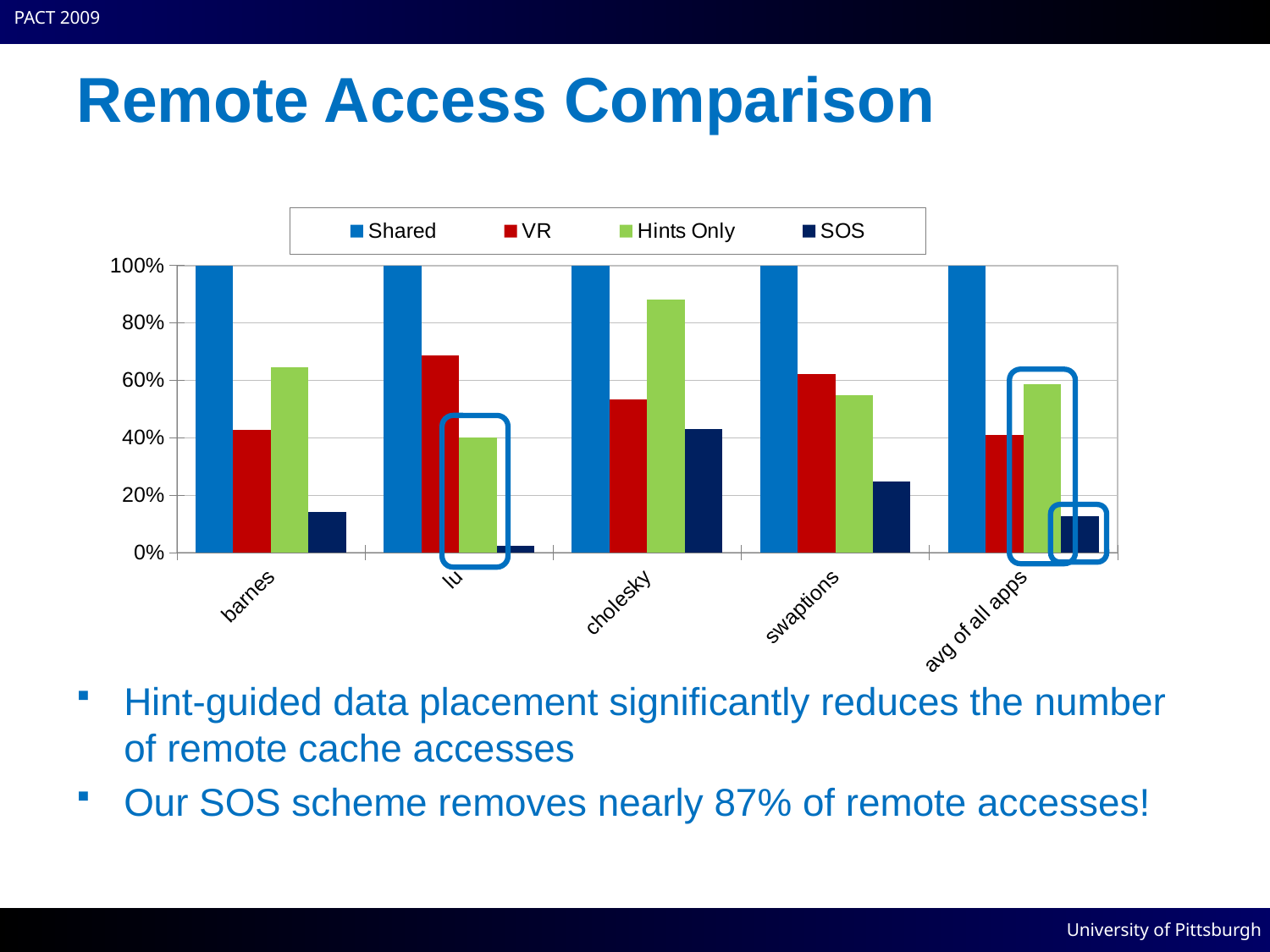
Is the VR value for cholesky greater or less than 60%? less How many series does the legend list? 4 For barnes, which is larger: the VR value or the Hints Only value? Hints Only Is the Hints Only value for cholesky greater or less than 80%? greater How many categories are shown on the x axis? 5 Which category has the lowest SOS value? lu What are the four series listed in the legend? Shared, VR, Hints Only, SOS What kind of chart is shown on the slide? bar chart For lu, which is larger: the VR value or the Hints Only value? VR Is the SOS value for lu greater or less than 20%? less Which category has the highest Hints Only value? cholesky What is the value of the Shared series for barnes? 100%